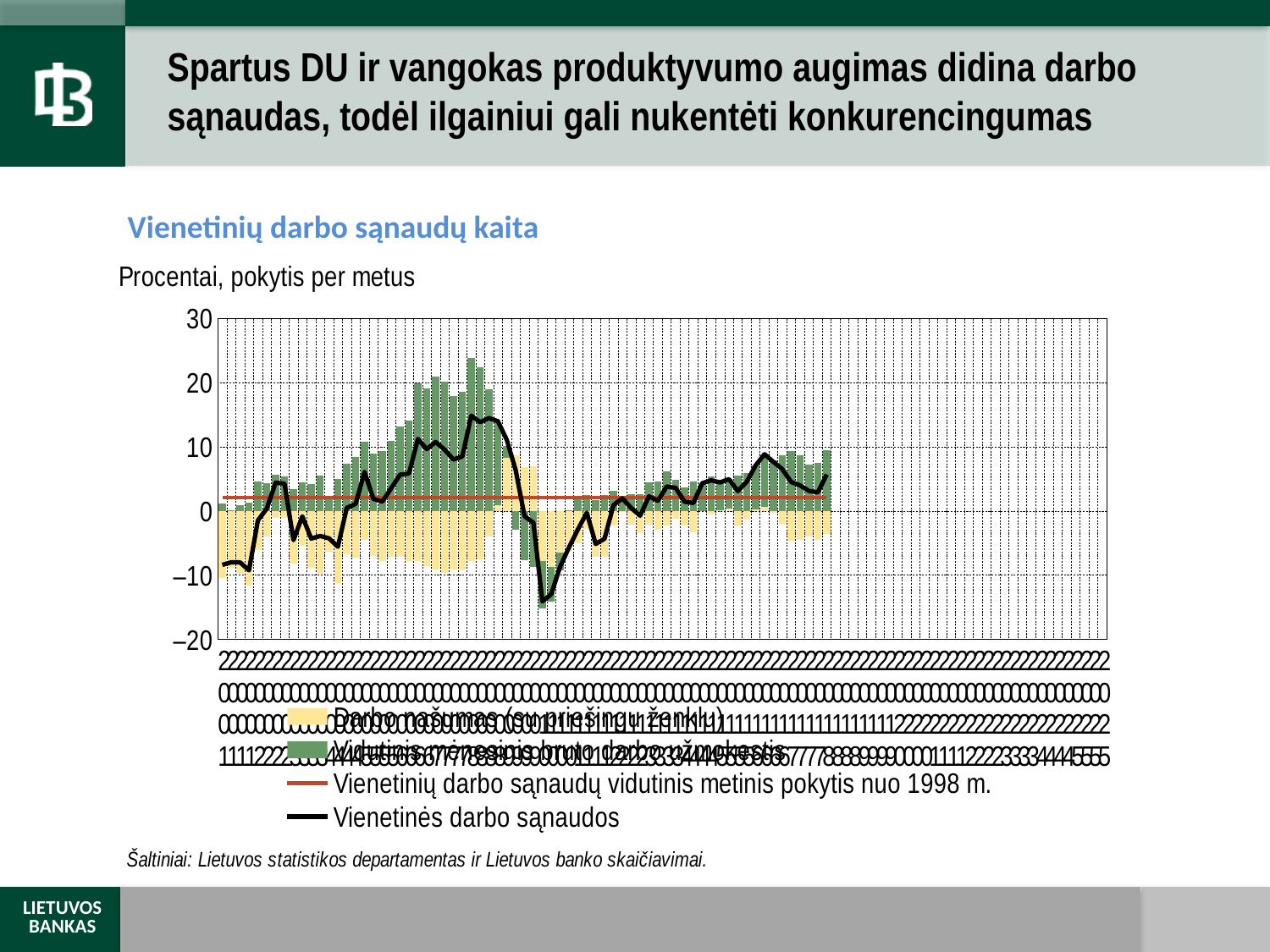
Is the red line (Vienetinių darbo sąnaudų vidutinis metinis pokytis nuo 1998 m.) greater or less than 10? less Is the tallest green bar (Vidutinis mėnesinis bruto darbo užmokestis) greater or less than 20? greater Which series in the chart is drawn as a black line? Vienetinės darbo sąnaudos How many series does the chart's legend list? 4 Is the red line (Vienetinių darbo sąnaudų vidutinis metinis pokytis nuo 1998 m.) greater or less than 0? greater What type of chart is shown on the slide? Combined bar and line chart What is the highest value shown on the chart's vertical axis? 30 What is the title of the chart on the slide? Vienetinių darbo sąnaudų kaita Does the red line in the chart rise, fall, or stay flat along the x axis? stays flat